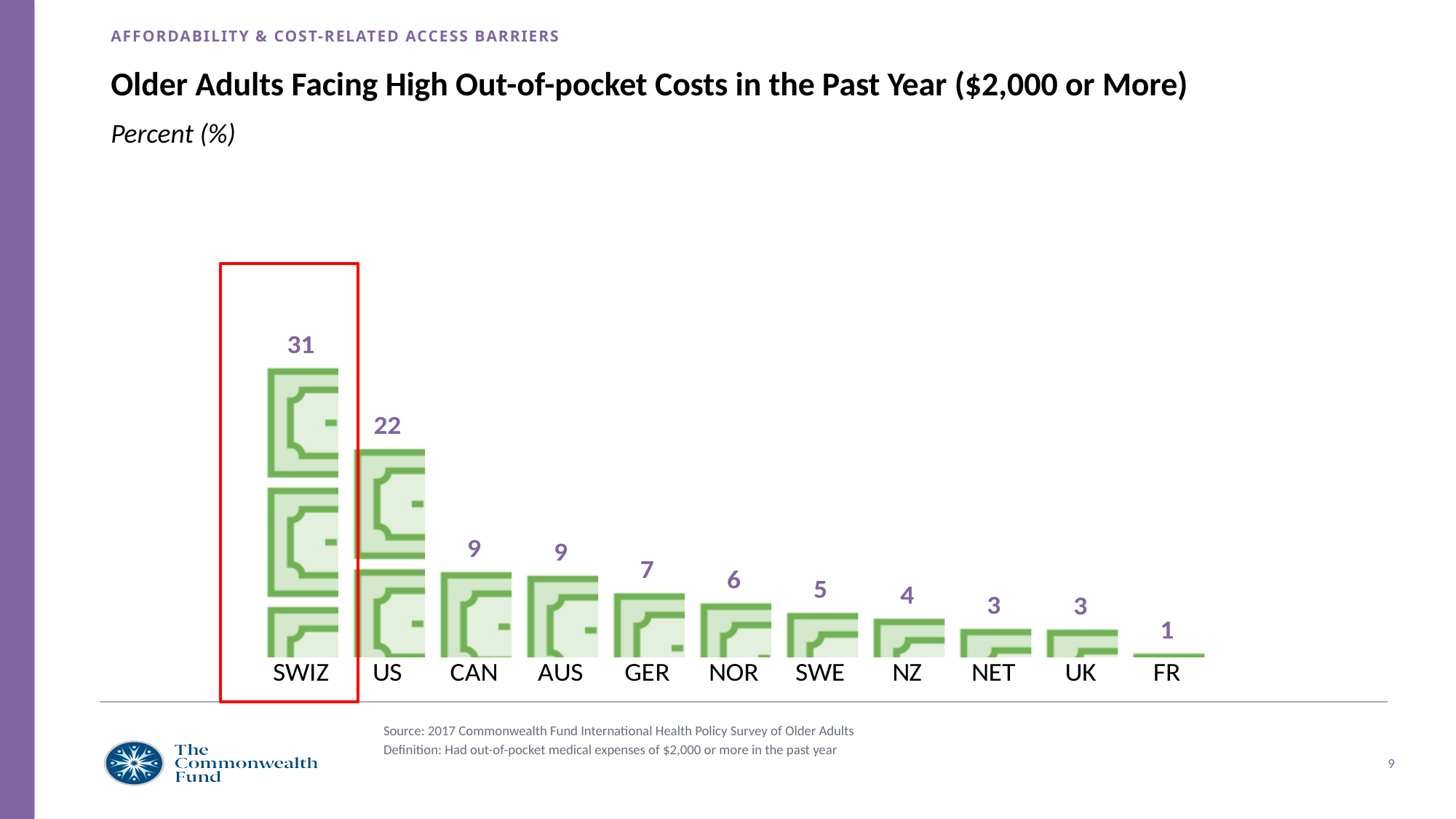
What kind of chart is this? Bar chart Which has a larger value, NOR or SWE? NOR What is the value for SWIZ? 31 What is the value for GER? 7 What is the value for US? 22 Which country is highlighted with a red box? SWIZ Which country has the highest value? SWIZ How many countries are shown in the chart? 11 What is the value for FR? 1 What is the difference between the values for SWIZ and US? 9 Do the values rise or fall from left to right along the x axis? Fall Which country has the lowest value? FR